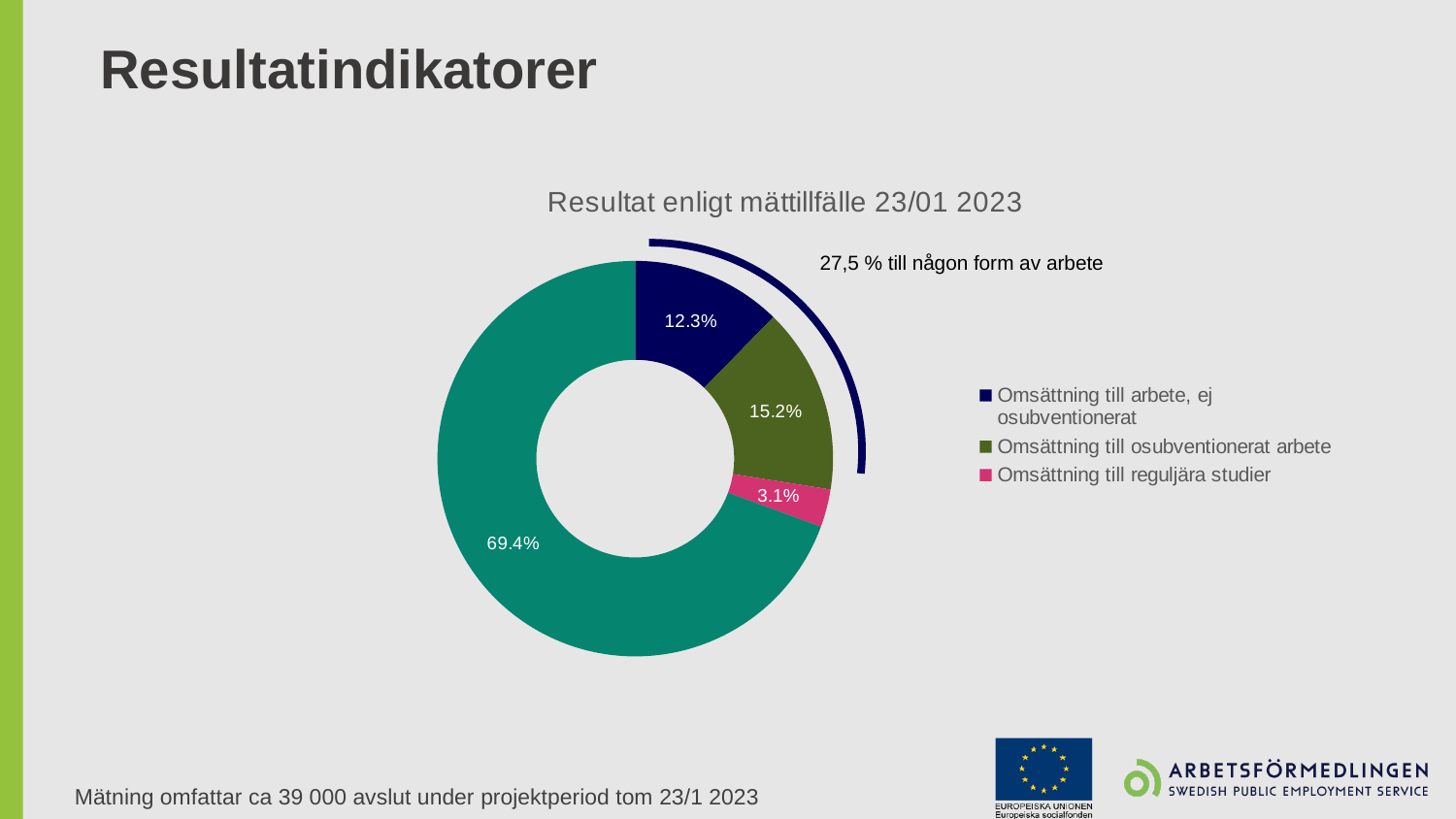
According to the annotation next to the chart, what share went to some form of work ('till någon form av arbete')? 27,5 % What kind of chart is shown on the slide? Donut (pie) chart How many entries does the legend list? 3 Which is larger: 'Omsättning till osubventionerat arbete' or 'Omsättning till arbete, ej osubventionerat'? Omsättning till osubventionerat arbete How many slices does the donut chart have? 4 What is the title of the chart? Resultat enligt mättillfälle 23/01 2023 What percentage is shown for 'Omsättning till arbete, ej osubventionerat'? 12.3% What is the value of the largest slice in the chart? 69.4% What percentage is shown for 'Omsättning till osubventionerat arbete'? 15.2% What is the difference between the 'Omsättning till osubventionerat arbete' slice and the 'Omsättning till reguljära studier' slice? 12.1 percentage points Which legend category has the smallest slice? Omsättning till reguljära studier What percentage is shown for 'Omsättning till reguljära studier'? 3.1%